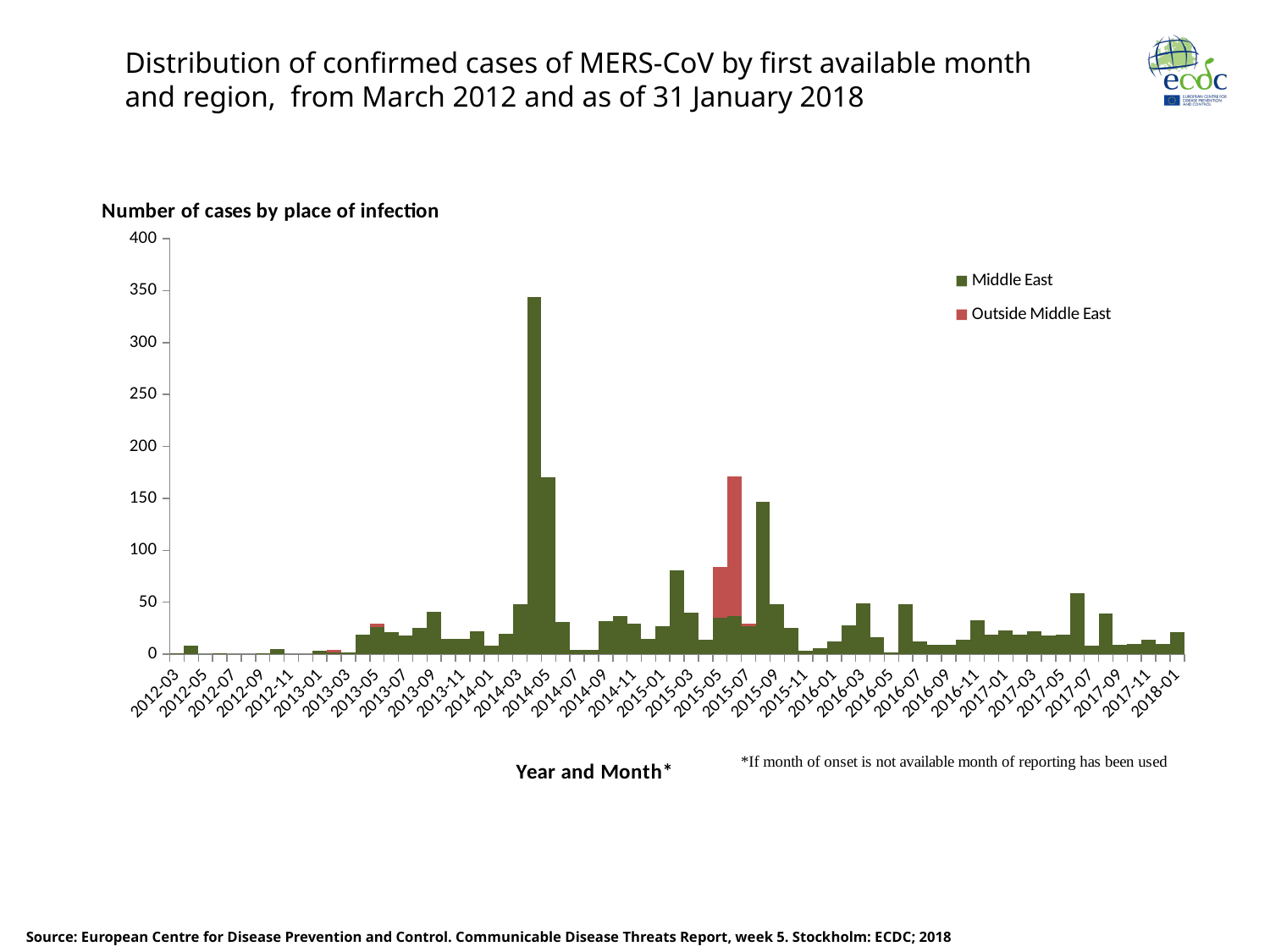
Which series does the tallest bar on the chart belong to? Middle East Is the tallest bar that includes Outside Middle East cases greater or less than 150? greater Is the value for 2013-09 greater or less than 50? less Is the value for 2017-09 greater or less than 50? less What are the two series named in the legend? Middle East; Outside Middle East What is the title of the x axis? Year and Month* How many series does the legend list? 2 What kind of chart is shown on the slide? Bar chart